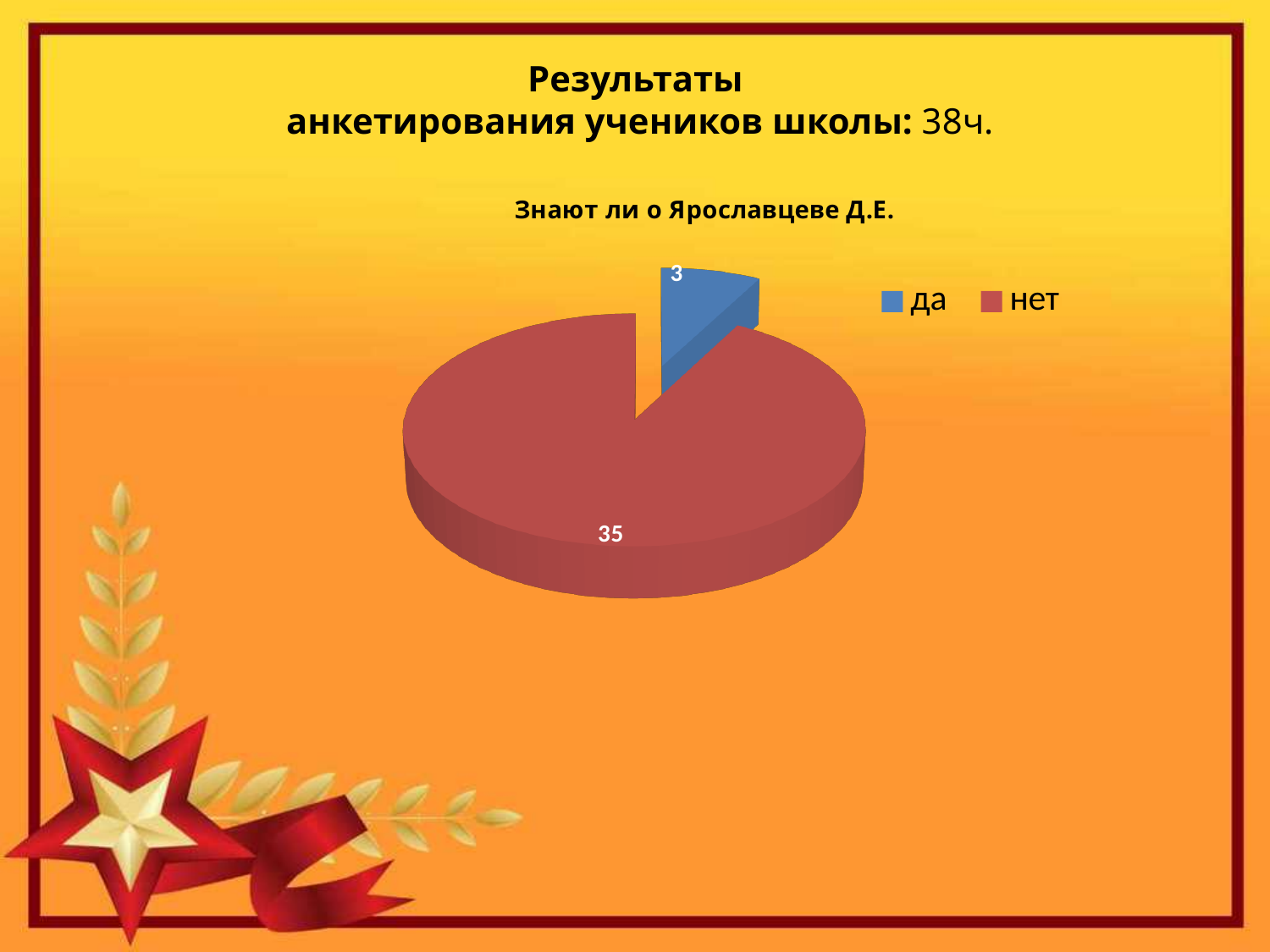
What is the title of the chart? Знают ли о Ярославцеве Д.Е. Which category has the smallest slice? да What is the value for "да"? 3 Which category has the largest slice? нет What is the value for "нет"? 35 Which is larger, the value for "да" or the value for "нет"? нет What is the total of all slices in the pie chart? 38 How many slices does the pie chart have? 2 How many series does the legend list? 2 What is the difference between the values for "нет" and "да"? 32 Which colour represents "да" in the legend? blue What kind of chart is shown on the slide? pie chart